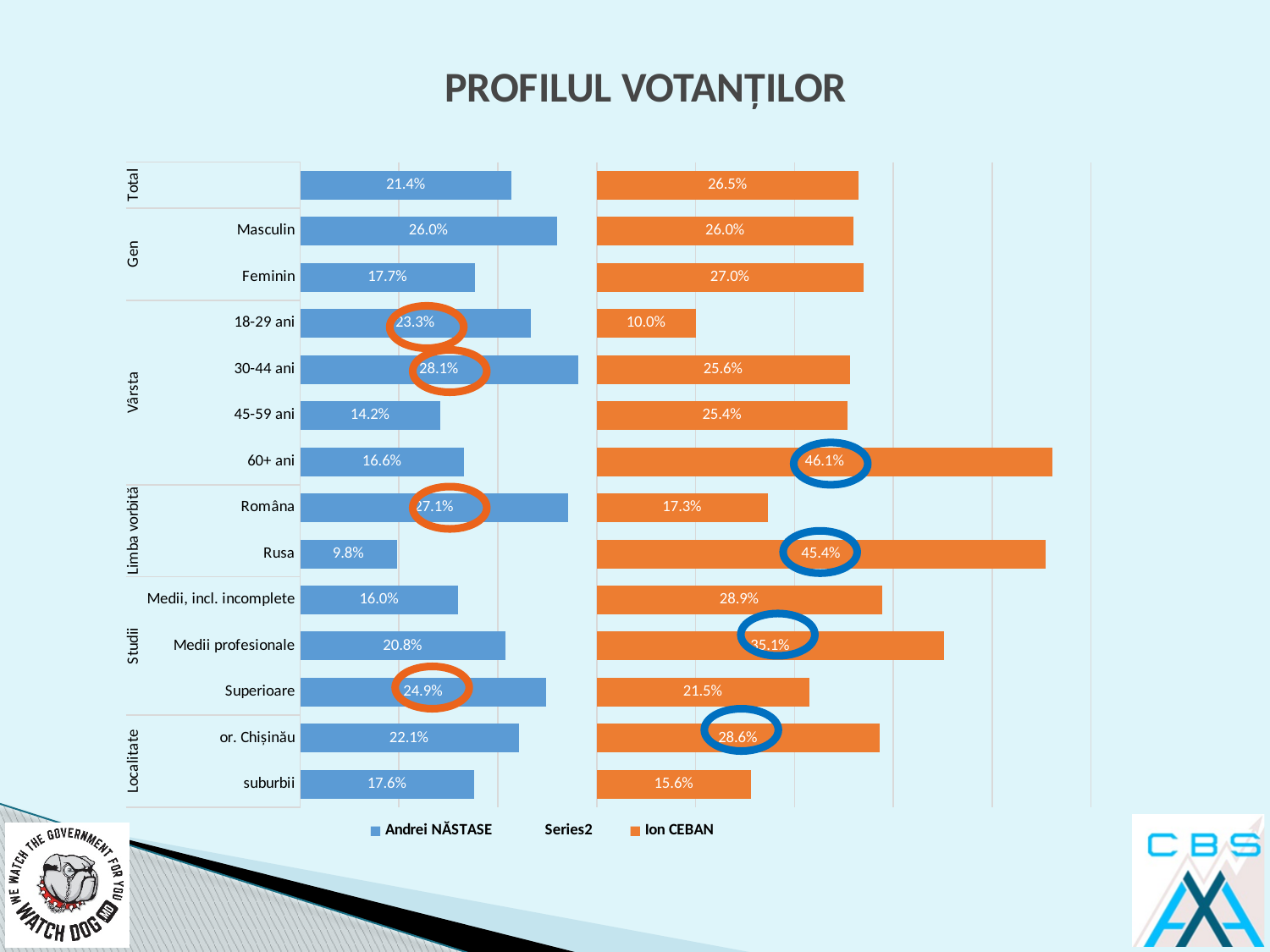
What is the value for Ion CEBAN in the Rusa category? 45.4% What kind of chart is shown on the slide? Bar chart In which category does Andrei NĂSTASE have his highest value? 30-44 ani What is the value for Ion CEBAN among respondents aged 60+ ani? 46.1% In which category does Ion CEBAN have his lowest value? 18-29 ani Who has the larger value in the 18-29 ani category, Andrei NĂSTASE or Ion CEBAN? Andrei NĂSTASE In which category does Andrei NĂSTASE have his lowest value? Rusa What is the difference between Ion CEBAN's and Andrei NĂSTASE's values in the Rusa category? 35.6 percentage points What is the title of the chart? PROFILUL VOTANȚILOR What is the value for Andrei NĂSTASE in the Total category? 21.4% What is the difference between Ion CEBAN's and Andrei NĂSTASE's values in the Total category? 5.1 percentage points How many categories are plotted on the chart? 14